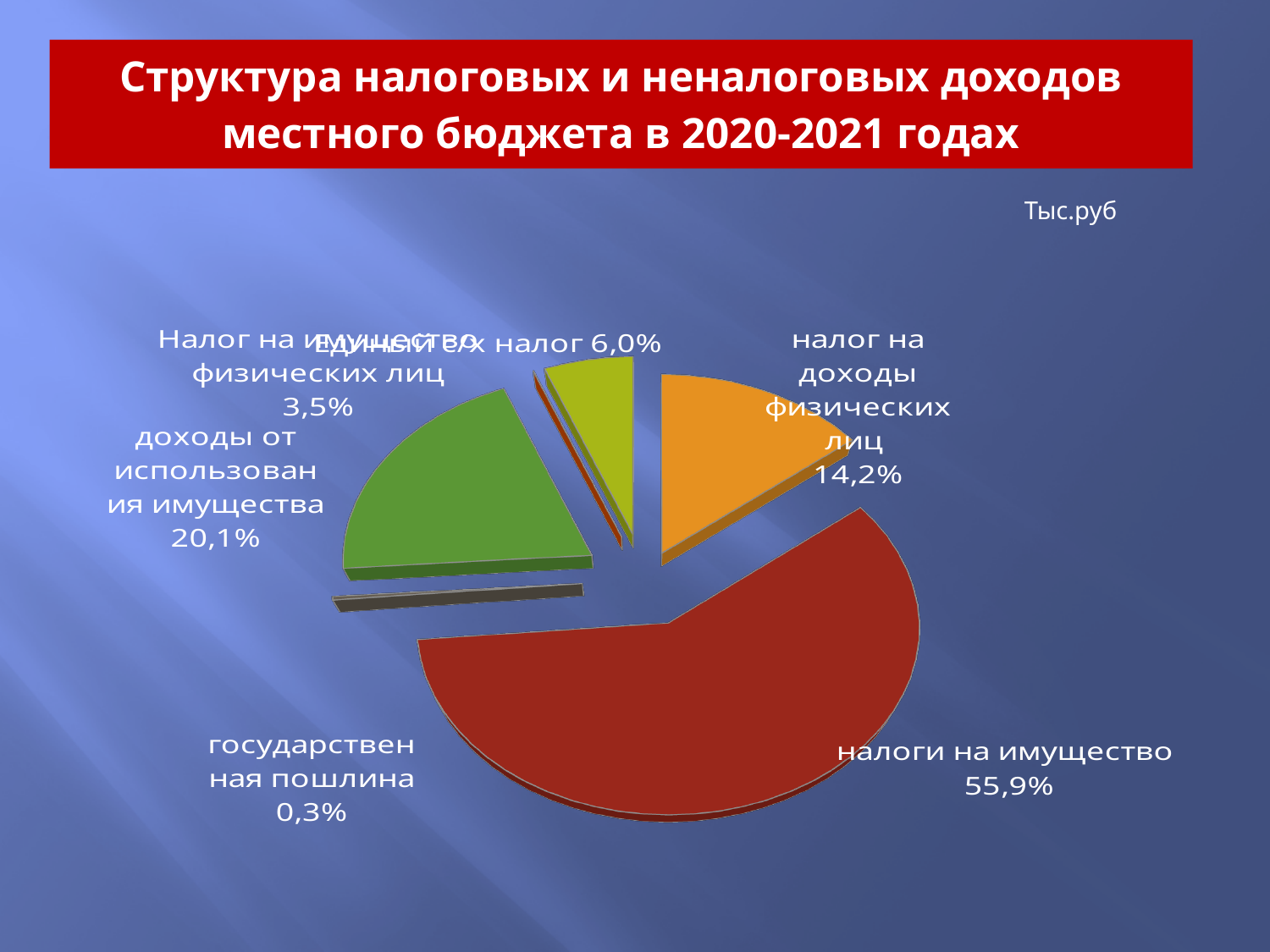
Which category has the smallest share of the pie? государственная пошлина What share of the pie is labelled for Единый с/х налог? 6,0% What kind of chart is shown on the slide? pie chart What share of the pie is labelled for налог на доходы физических лиц? 14,2% What share of the pie is labelled for доходы от использования имущества? 20,1% How many slices does the pie chart have? 6 Which category has the largest share of the pie? налоги на имущество What is the difference between the shares of налоги на имущество and доходы от использования имущества? 35,8% Which is larger: the share of налог на доходы физических лиц or the share of Единый с/х налог? налог на доходы физических лиц What unit is indicated in the top right of the slide above the chart? Тыс.руб